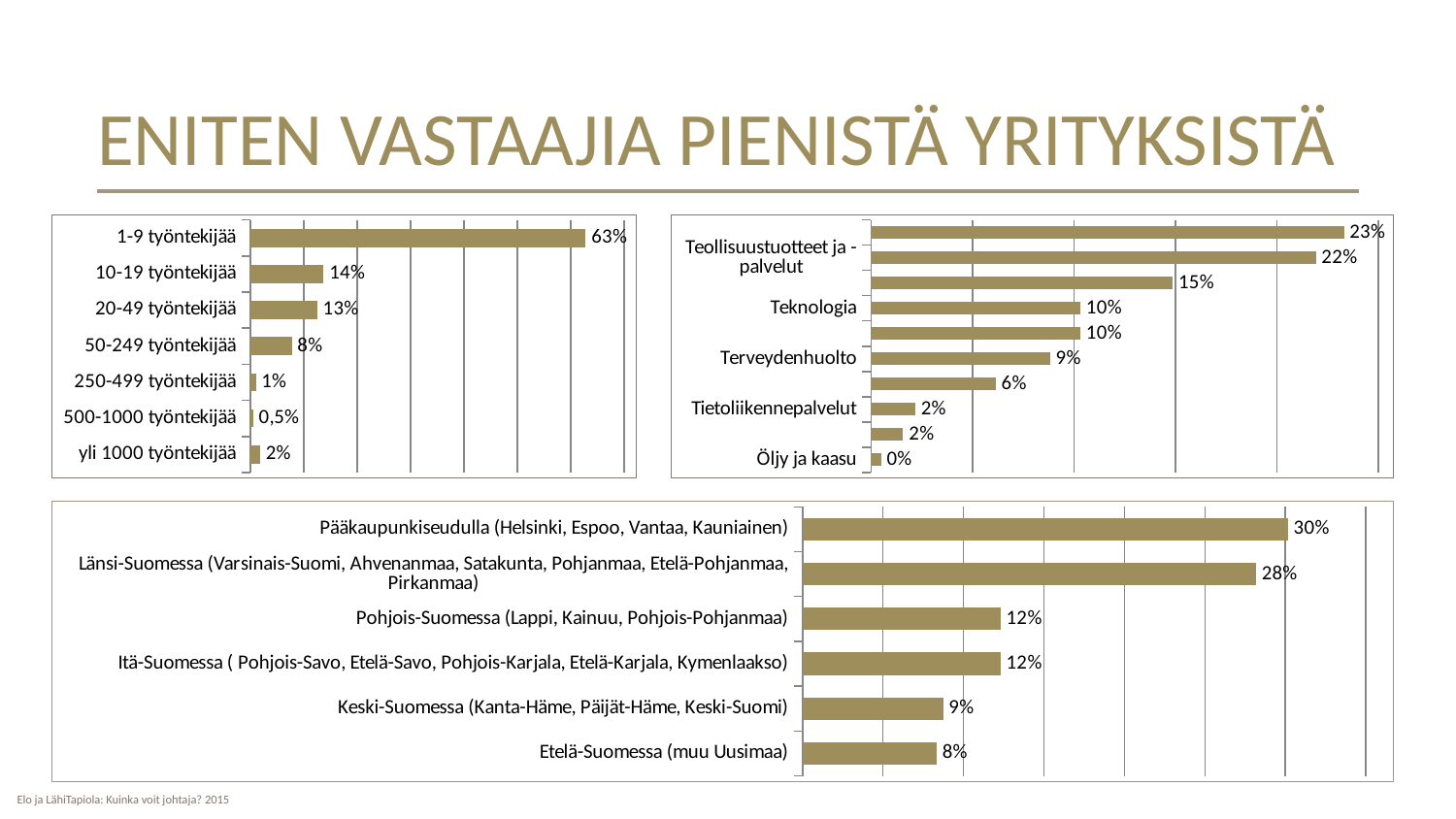
In the bottom chart, which category has the highest value? Pääkaupunkiseudulla (Helsinki, Espoo, Vantaa, Kauniainen) In the top-right chart, which is larger: the value for Teknologia or the value for Tietoliikennepalvelut? Teknologia In the top-left chart, which category has the highest value? 1-9 työntekijää In the top-left chart, which category has the lowest value? 500-1000 työntekijää In the top-right chart, what is the value for Öljy ja kaasu? 0% In the top-right chart, what is the value for Terveydenhuolto? 9% In the top-left chart, what is the value for 500-1000 työntekijää? 0,5% In the top-left chart, what is the value for 1-9 työntekijää? 63% How many categories are shown in the top-left chart? 7 In the bottom chart, what is the value for Keski-Suomessa (Kanta-Häme, Päijät-Häme, Keski-Suomi)? 9% In the top-left chart, what is the difference between the values for 10-19 työntekijää and 20-49 työntekijää? 1% What type of chart is the bottom chart? Bar chart